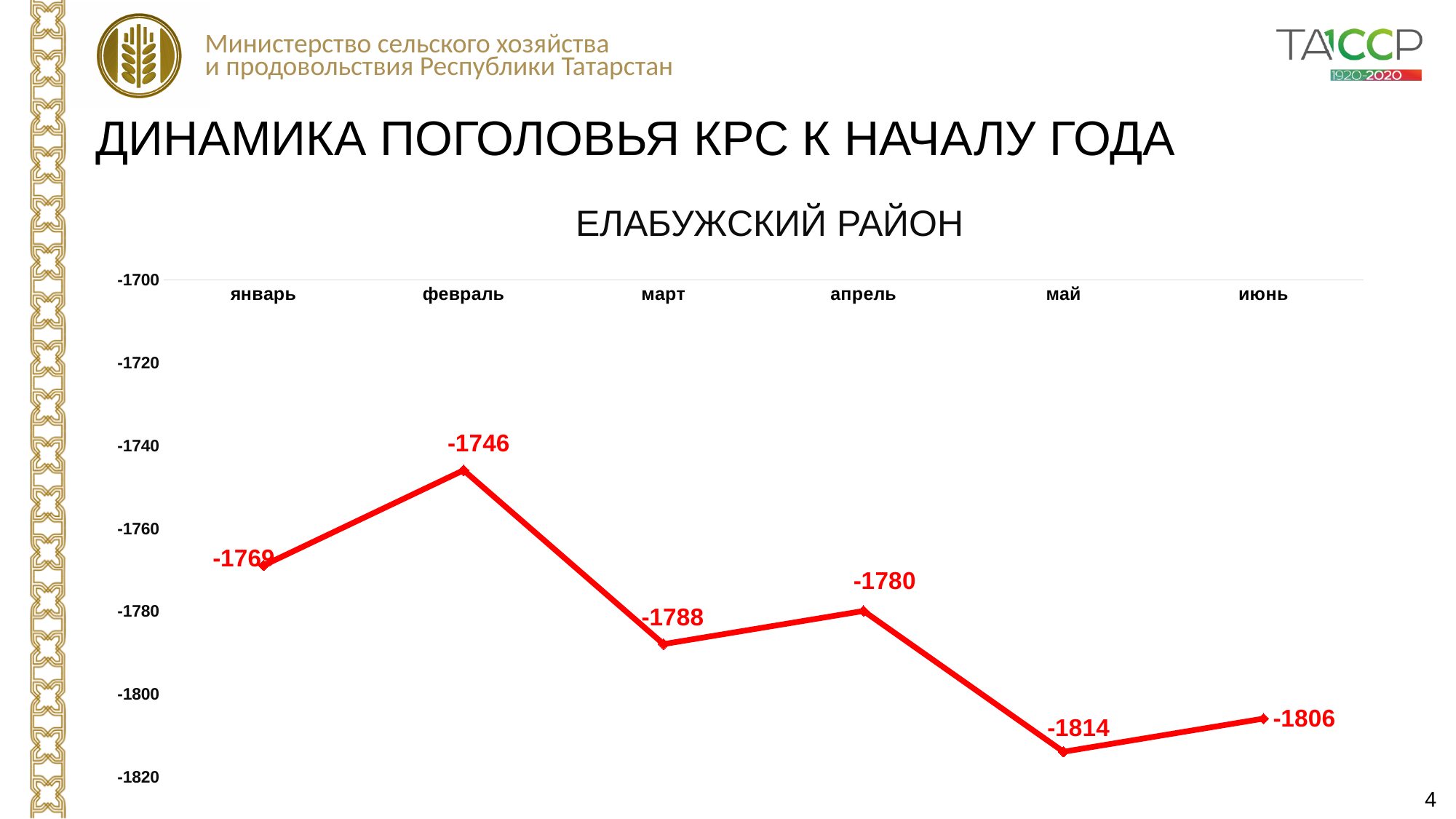
What is the value for апрель on the chart? -1780 Which month has the lowest value on the chart? май Which month has the highest value on the chart? февраль What kind of chart is shown on the slide? line chart Which is larger, the value for апрель or the value for май? апрель What is the difference between the values for февраль and март? 42 What is the value for июнь on the chart? -1806 Is the value for январь greater or less than -1760? less What is the value for март on the chart? -1788 What is the value for май on the chart? -1814 What is the value for февраль on the chart? -1746 How many months are plotted on the chart? 6